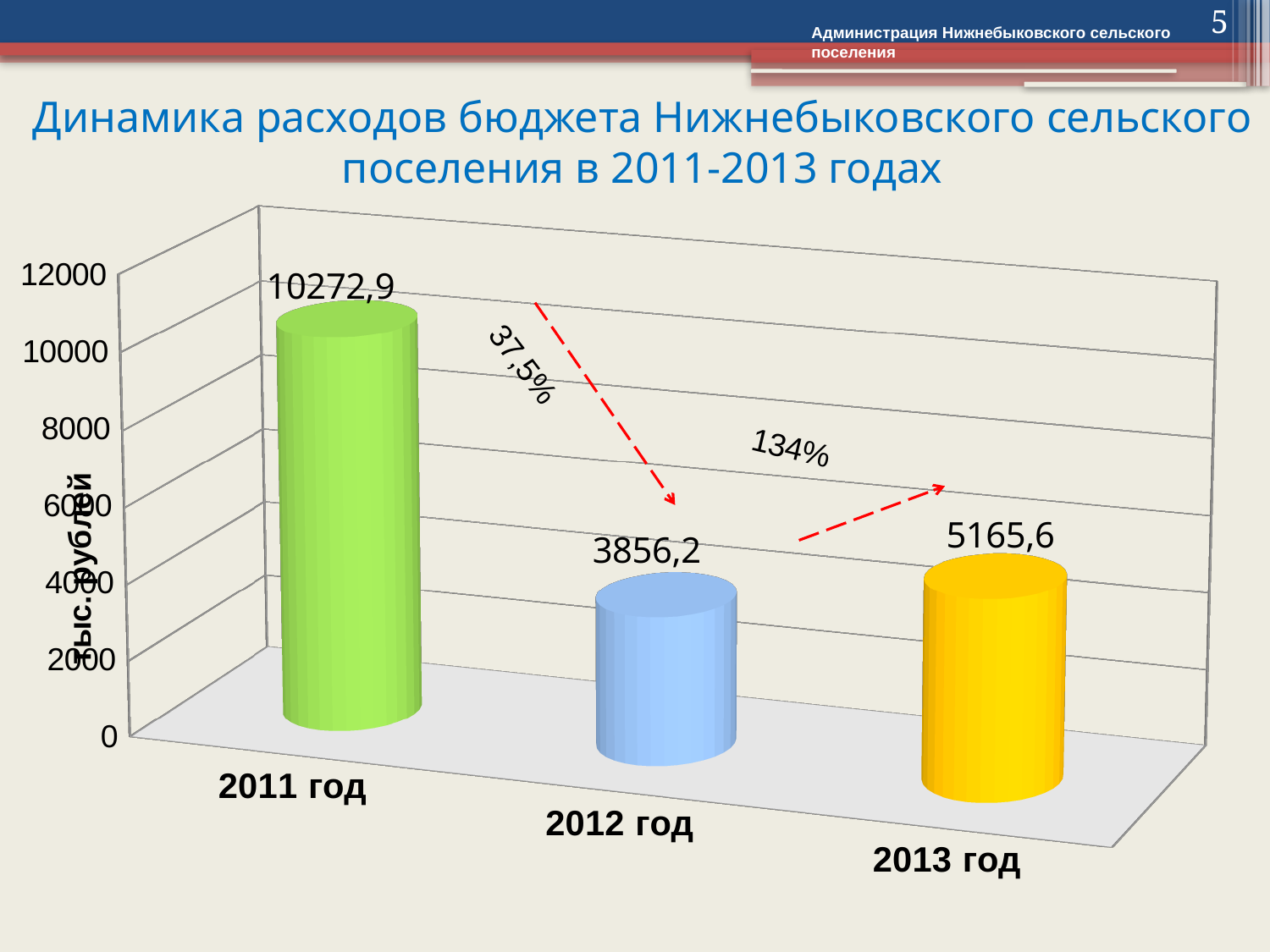
How many years are shown in the chart? 3 What is the difference between the values for 2013 год and 2012 год? 1309,4 What is the value for 2012 год? 3856,2 Which year has the highest value? 2011 год What is the difference between the values for 2011 год and 2012 год? 6416,7 What is the value for 2013 год? 5165,6 What is the label of the vertical axis? тыс. рублей Which is larger, the value for 2012 год or the value for 2013 год? 2013 год What is the value for 2011 год? 10272,9 Which year has the lowest value? 2012 год Is the value for 2011 год greater or less than 10000? greater What kind of chart is shown on the slide? bar chart